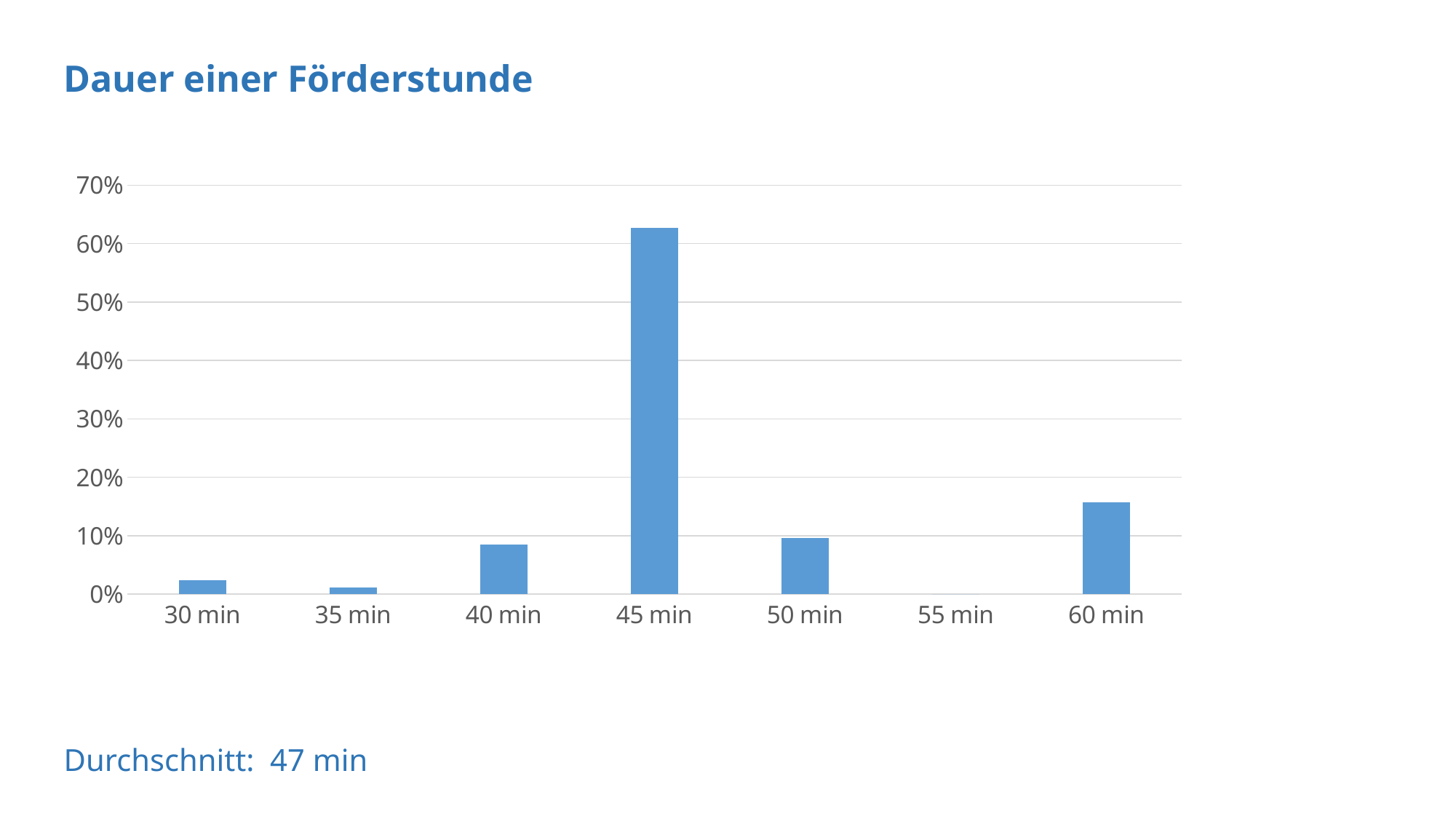
How many duration categories are shown on the x axis? 7 What kind of chart is shown on the slide? bar chart Which duration category has the highest value? 45 min Is the value for 60 min greater or less than 10%? greater Is the value for 60 min greater or less than 20%? less Which has the larger value, 40 min or 45 min? 45 min Which duration category has the lowest value? 55 min Which has the larger value, 50 min or 60 min? 60 min What average duration (Durchschnitt) is stated below the chart? 47 min What is the title of the chart? Dauer einer Förderstunde Is the value for 45 min greater or less than 60%? greater